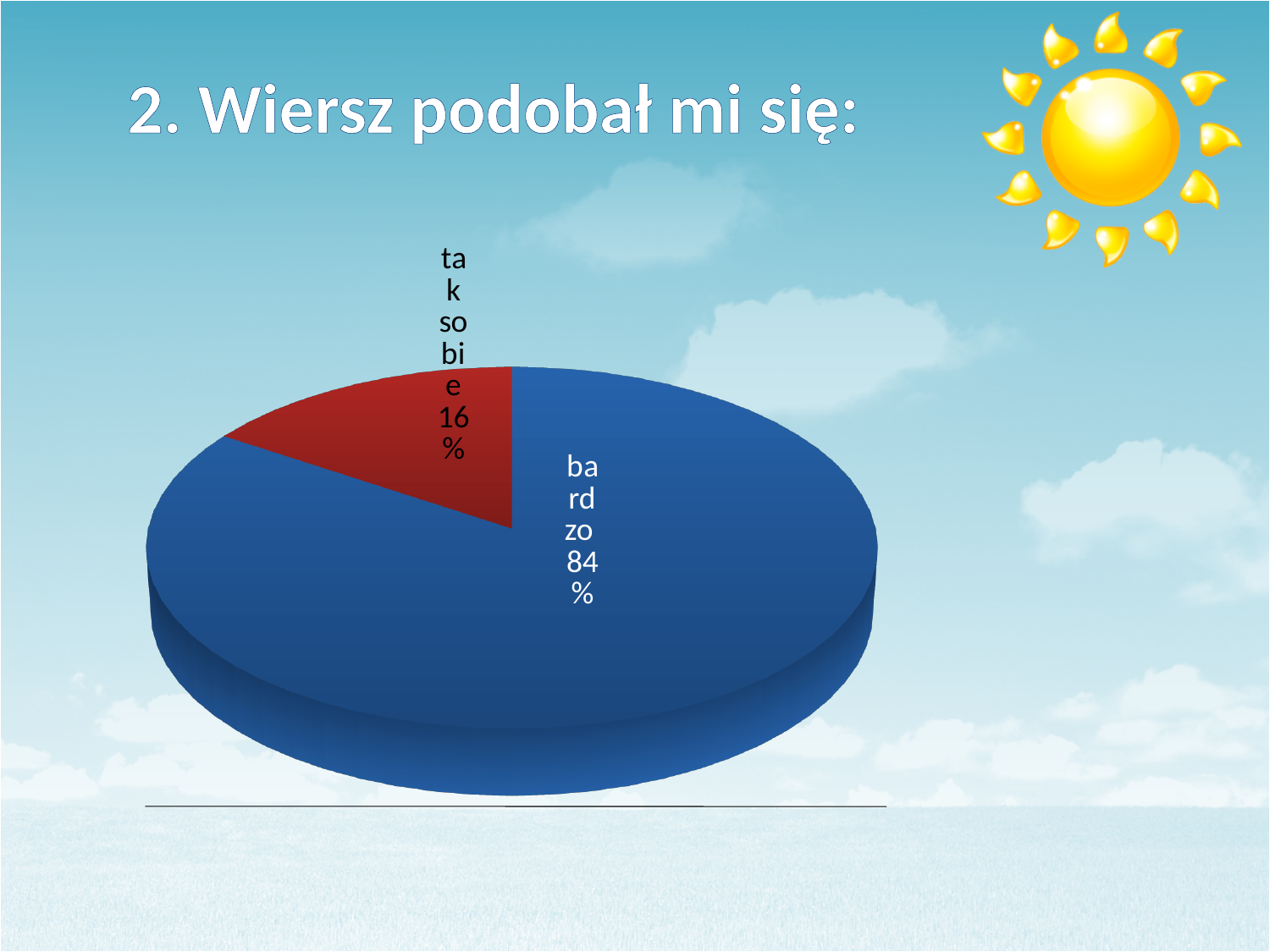
Which slice is the smallest? tak sobie How many slices does the pie chart have? 2 What kind of chart is shown on the slide? pie chart Which is larger, the "bardzo" slice or the "tak sobie" slice? bardzo What is the difference in percentage points between the "bardzo" and "tak sobie" slices? 68 What colour is the "tak sobie" slice? red Which slice is the largest? bardzo What percentage is shown for the "tak sobie" slice? 16% What is the title of the slide containing the chart? 2. Wiersz podobał mi się: What percentage is shown for the "bardzo" slice? 84% What share of the pie does the "tak sobie" slice represent? 16%